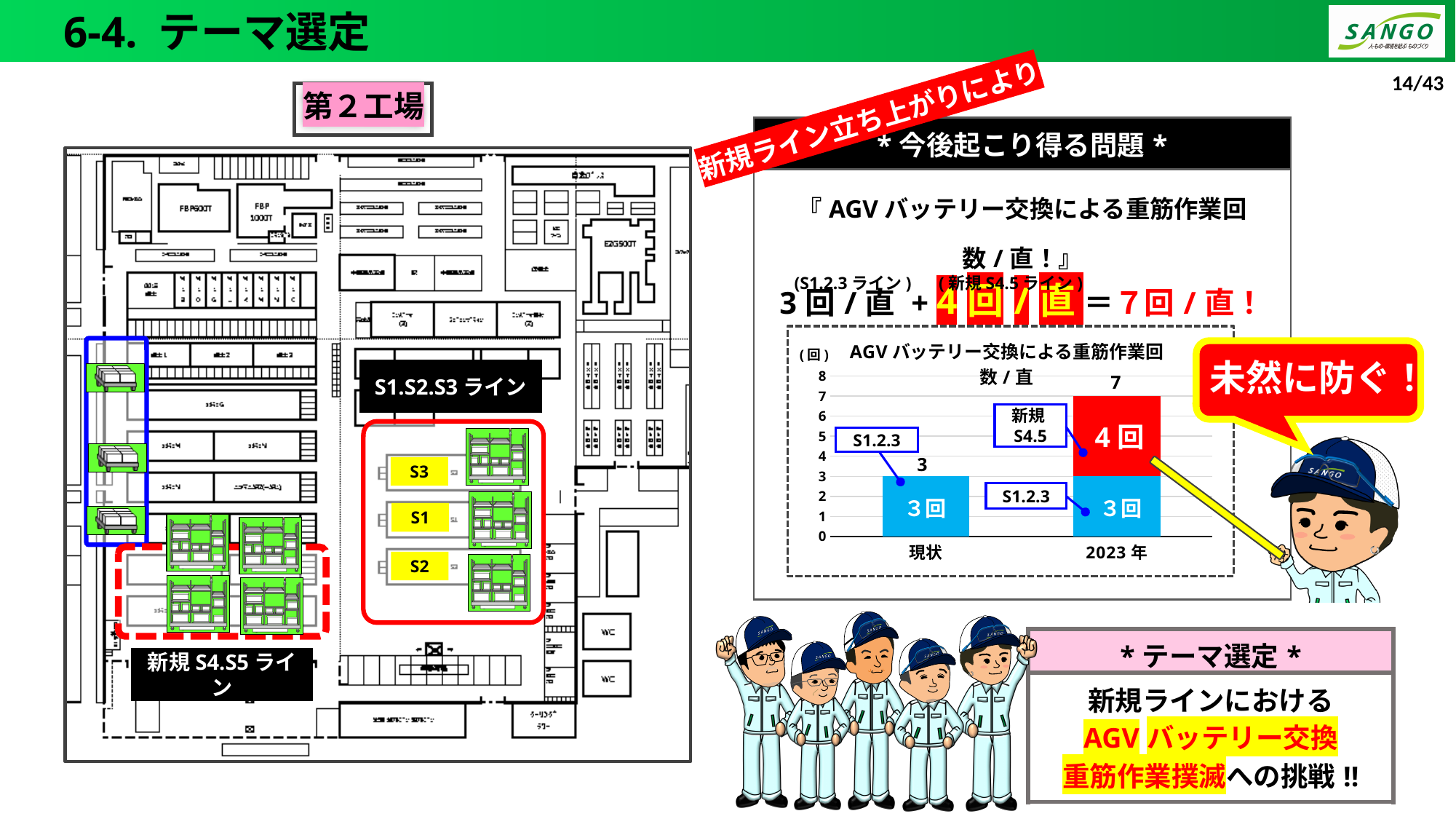
What type of chart is shown on the slide? bar chart What is the value of the S1.2.3 segment in the 2023年 bar? 3回 What is the total value of the bar for 2023年? 7 What is the value of the S1.2.3 segment in the 現状 bar? 3回 What is the maximum value shown on the y axis of the chart? 8 Which category has the higher total, 現状 or 2023年? 2023年 What is the title of the chart? AGVバッテリー交換による重筋作業回数/直 What is the total value of the bar for 現状? 3 How many categories are shown on the x axis of the chart? 2 Do the totals rise or fall from 現状 to 2023年? rise What is the value of the 新規S4.5 segment in the 2023年 bar? 4回 What is the difference between the total for 2023年 and the total for 現状? 4